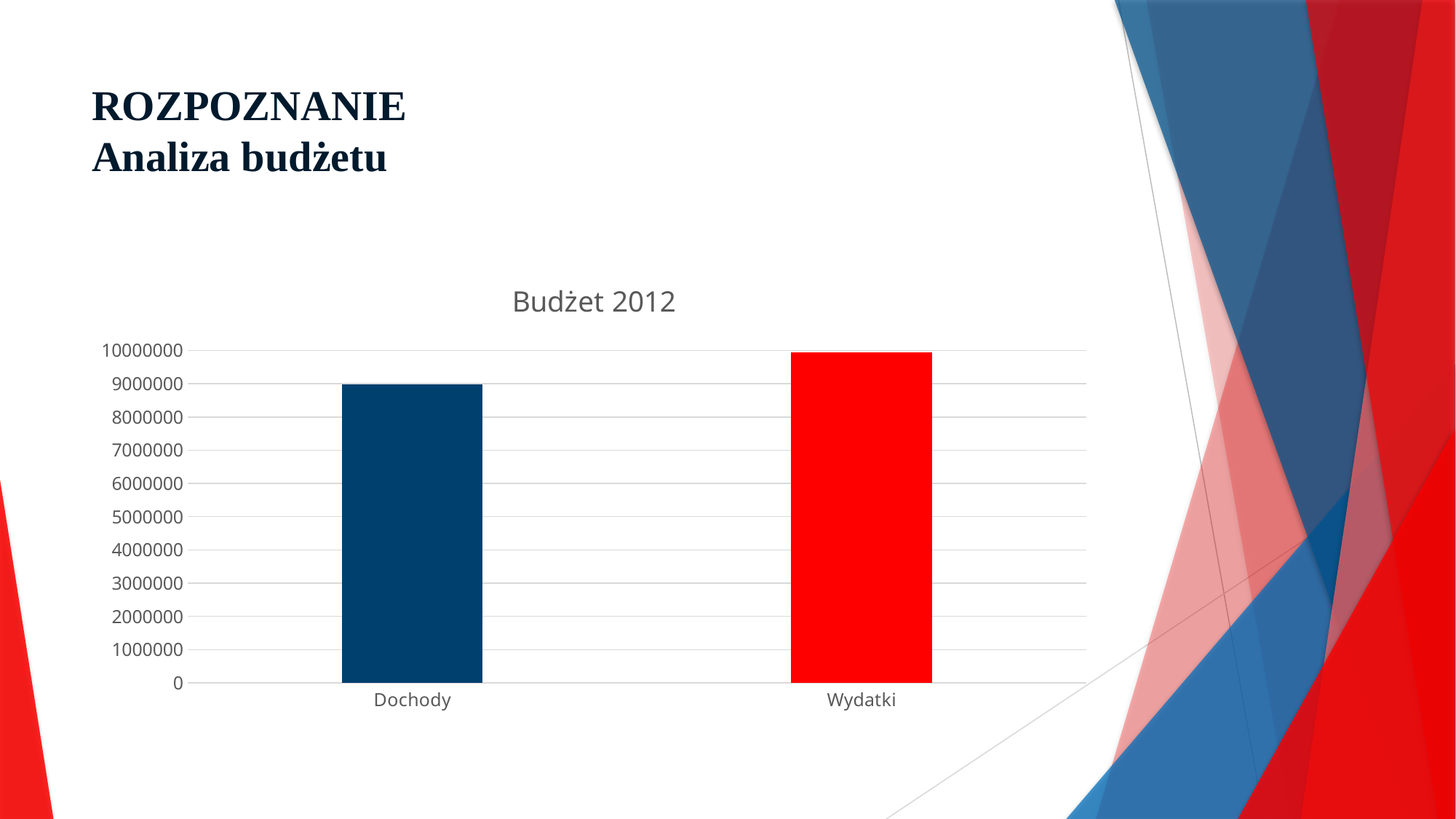
Which category has the lowest value? Dochody What is the title of the chart? Budżet 2012 Is the value for Wydatki greater or less than 5000000? greater How many categories are shown in the chart? 2 Is the value for Dochody greater or less than 8000000? greater Do the values rise or fall from Dochody to Wydatki along the x axis? rise Which is larger, the value for Dochody or the value for Wydatki? Wydatki What type of chart is shown on the slide? bar chart What colour is the bar for Wydatki? red Is the value for Dochody greater or less than 10000000? less Which category has the highest value? Wydatki